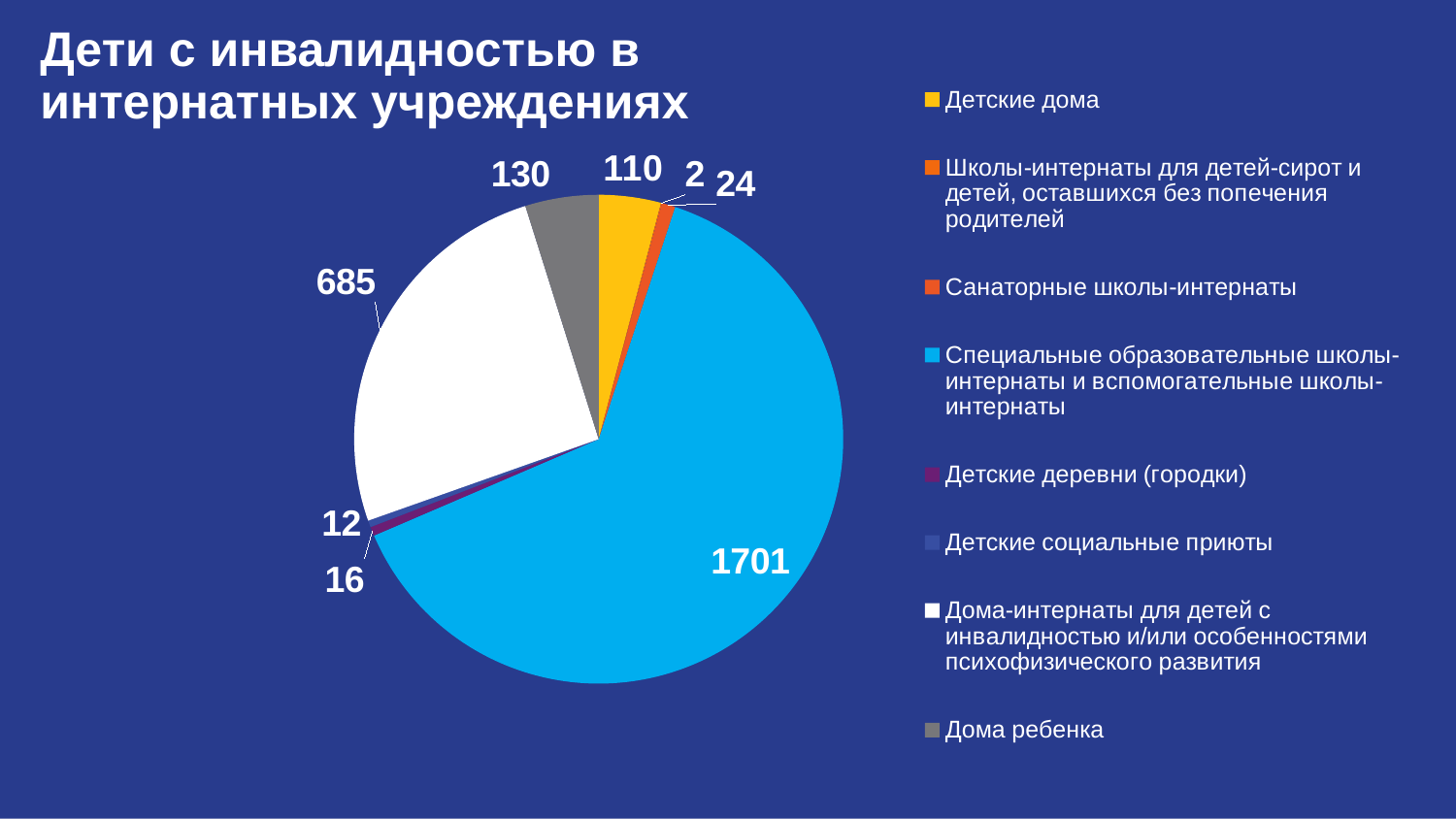
What is the value for Дома ребенка? 130 How many categories does the legend list? 8 Which category has the largest slice of the pie? Специальные образовательные школы-интернаты и вспомогательные школы-интернаты Which category has the smallest value? Школы-интернаты для детей-сирот и детей, оставшихся без попечения родителей What is the value for Специальные образовательные школы-интернаты и вспомогательные школы-интернаты? 1701 What is the value for Школы-интернаты для детей-сирот и детей, оставшихся без попечения родителей? 2 Which is larger, the value for Дома ребенка or the value for Детские дома? Дома ребенка What is the difference between the value for Специальные образовательные школы-интернаты и вспомогательные школы-интернаты and the value for Дома-интернаты для детей с инвалидностью и/или особенностями психофизического развития? 1016 What is the value for Детские дома? 110 What is the value for Санаторные школы-интернаты? 24 What is the value for Дома-интернаты для детей с инвалидностью и/или особенностями психофизического развития? 685 What kind of chart is shown on the slide? Pie chart